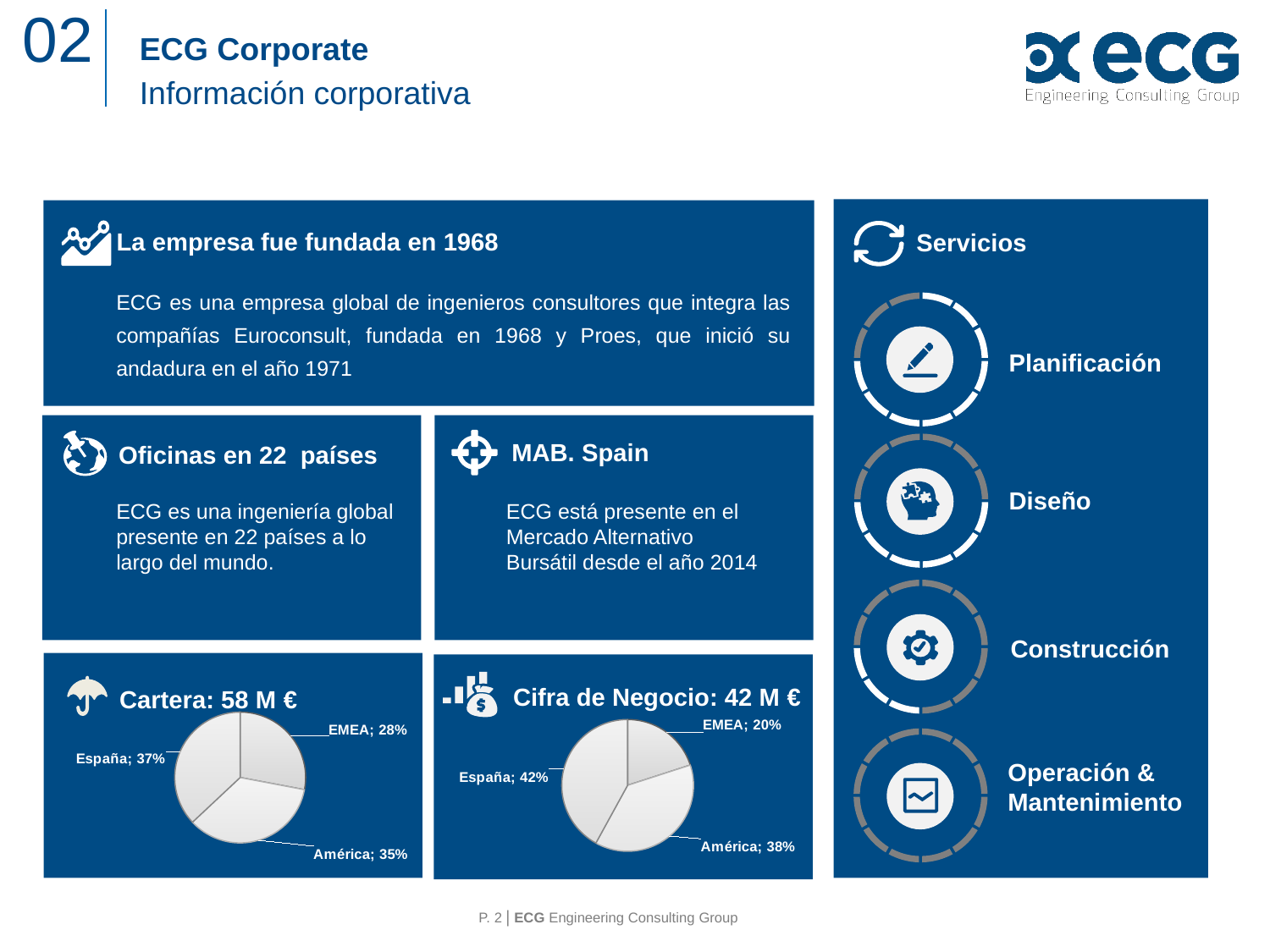
In the 'Cifra de Negocio: 42 M €' pie chart, what share does América have? 38% In the 'Cartera: 58 M €' pie chart, what share does España have? 37% In the 'Cartera: 58 M €' pie chart, which region has the largest share? España What type of chart is used for 'Cartera: 58 M €'? Pie chart In the 'Cartera: 58 M €' pie chart, what is the difference between the shares of América and EMEA? 7% In the 'Cifra de Negocio: 42 M €' pie chart, which region has the smallest share? EMEA In the 'Cartera: 58 M €' pie chart, which is larger, the share of España or the share of EMEA? España In the 'Cifra de Negocio: 42 M €' pie chart, what share does EMEA have? 20% How many slices does the 'Cifra de Negocio: 42 M €' pie chart have? 3 In the 'Cifra de Negocio: 42 M €' pie chart, what is the difference between the shares of España and EMEA? 22% In the 'Cartera: 58 M €' pie chart, what share does EMEA have? 28% What is the title of the pie chart on the right of the two charts at the bottom of the slide? Cifra de Negocio: 42 M €